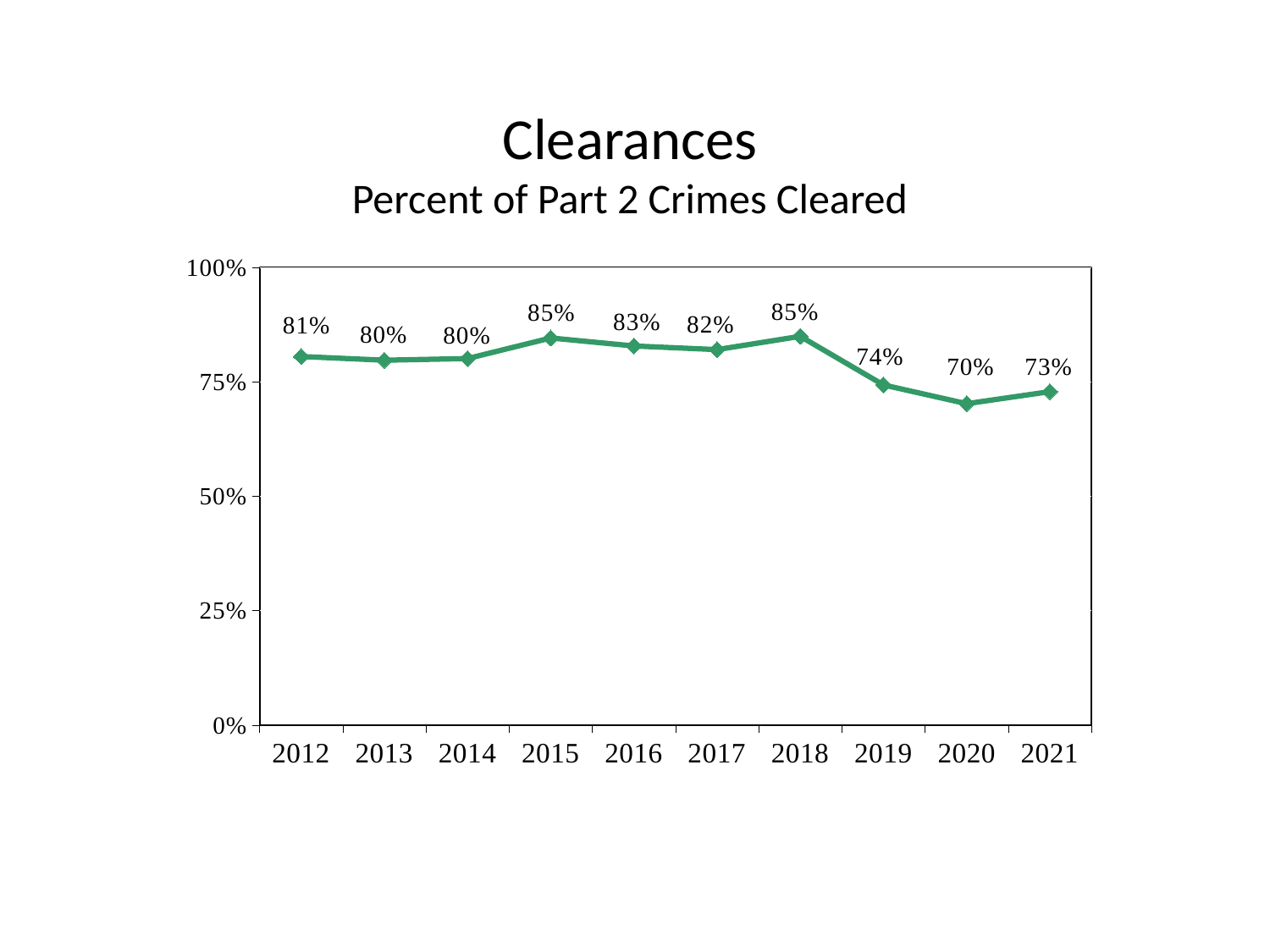
How many years are plotted on the chart? 10 Do the values rise or fall from 2018 to 2020? fall What is the value shown for 2019? 74% What is the subtitle of the chart? Percent of Part 2 Crimes Cleared Which year has the lowest percent of Part 2 crimes cleared? 2020 What percent of Part 2 crimes were cleared in 2012? 81% What is the difference between the values for 2012 and 2021? 8% What is the difference between the values for 2018 and 2020? 15% What kind of chart is shown on the slide? line chart What is the value shown for 2021? 73% Which is larger, the value for 2016 or the value for 2019? 2016 Is the value for 2020 greater or less than 75%? less